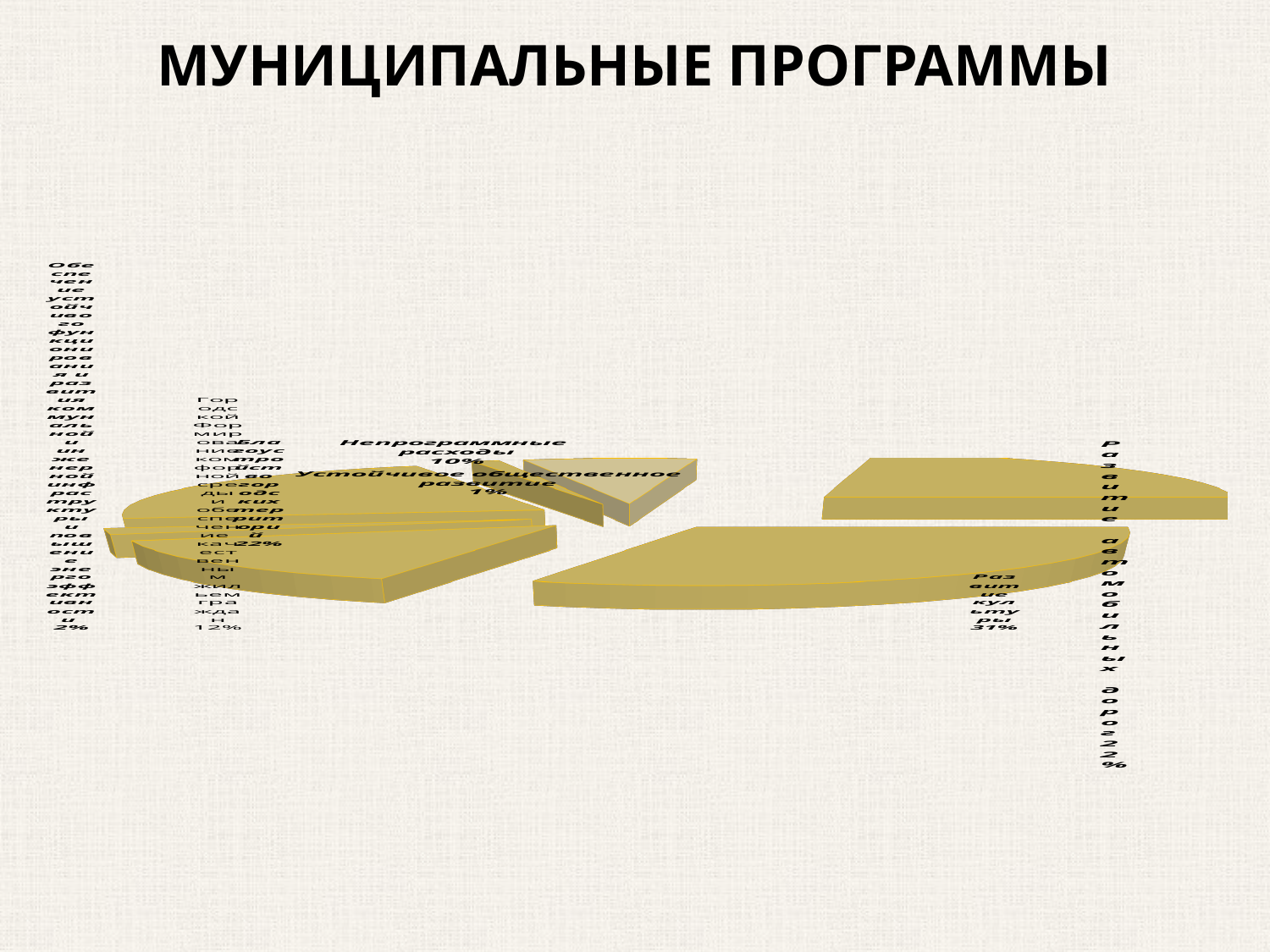
What is the title of the slide containing the chart? МУНИЦИПАЛЬНЫЕ ПРОГРАММЫ Is the share for "Развитие культуры" greater or less than 25%? greater By how many percentage points does "Развитие культуры" exceed "Непрограммные расходы"? 21% What share of the pie is labelled "Устойчивое общественное развитие"? 1% Which is larger: the share for "Развитие культуры" or the share for "Непрограммные расходы"? Развитие культуры By how many percentage points does "Развитие автомобильных дорог" exceed "Непрограммные расходы"? 12% Which slice of the pie is the smallest? Устойчивое общественное развитие What share of the pie is labelled "Развитие автомобильных дорог"? 22% What kind of chart is shown on the slide? pie chart Which slice of the pie is the largest? Развитие культуры What share of the pie is labelled "Непрограммные расходы"? 10% What share of the pie is labelled "Развитие культуры"? 31%